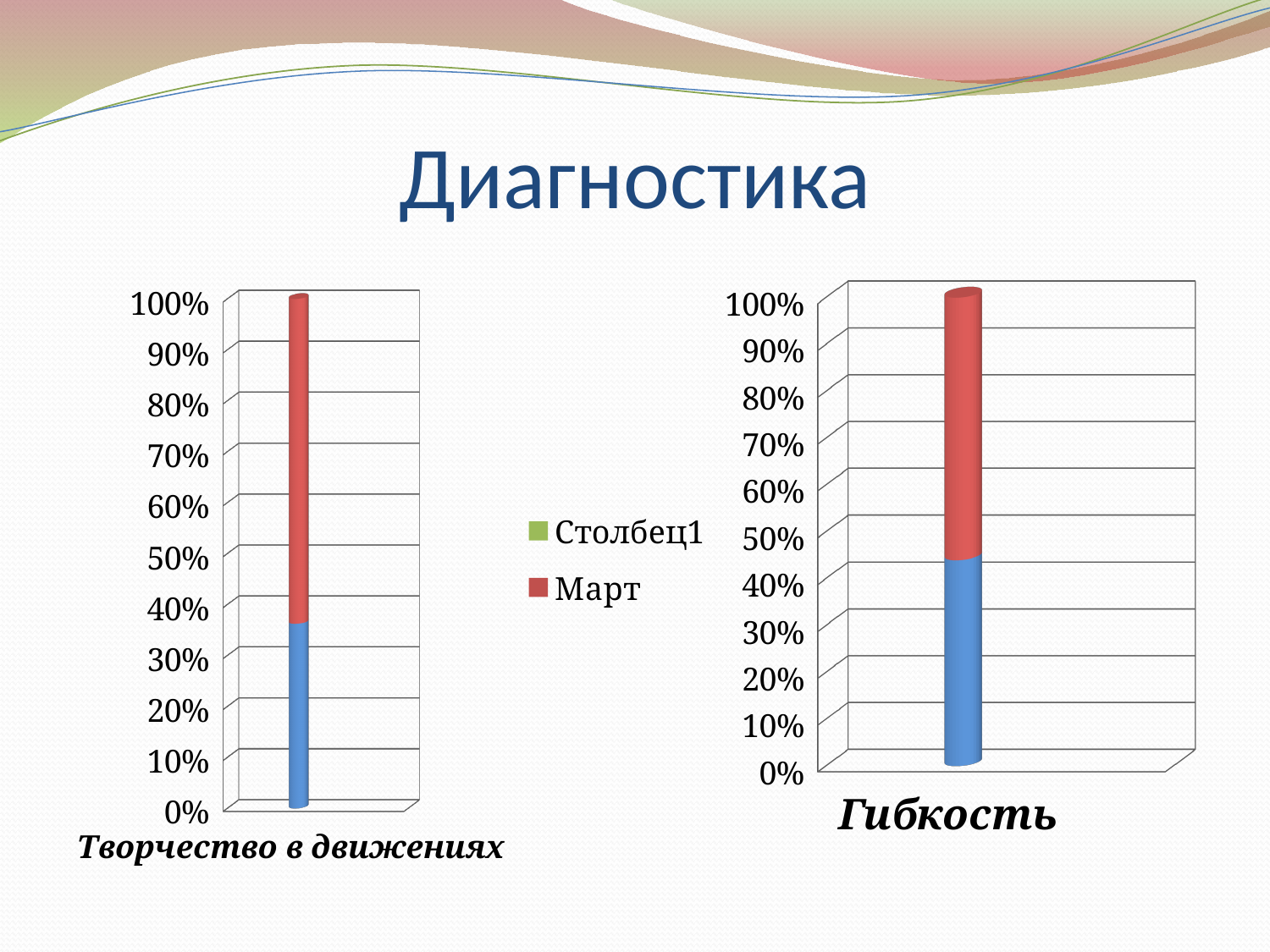
What kind of chart is the 'Творчество в движениях' chart? bar chart What colour is the 'Март' series in the legend? red In the 'Творчество в движениях' chart, is the top of the blue segment greater or less than 30%? greater In the 'Гибкость' chart, is the top of the blue segment greater or less than 50%? less What is the highest value shown on the vertical axis of the 'Гибкость' chart? 100% Which chart has the larger blue segment, 'Творчество в движениях' or 'Гибкость'? Гибкость What kind of chart is the 'Гибкость' chart? bar chart How many bars are plotted in the 'Гибкость' chart? 1 In the 'Творчество в движениях' chart, is the top of the blue segment greater or less than 40%? less What are the two entries in the legend on the slide? Столбец1 and Март How many series does the legend on the slide list? 2